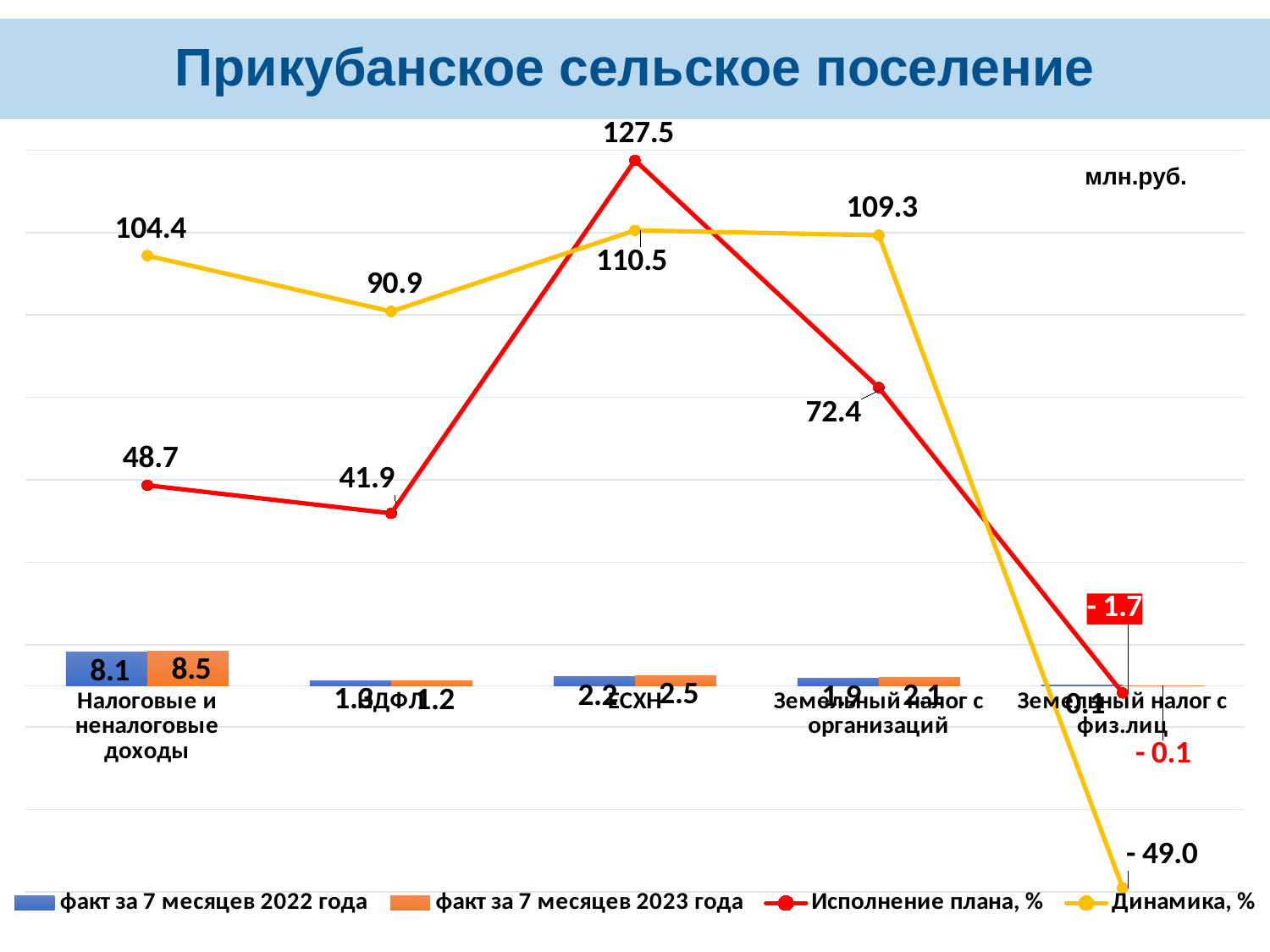
What is the title of the slide? Прикубанское сельское поселение What is the difference between факт за 7 месяцев 2023 года and факт за 7 месяцев 2022 года for Налоговые и неналоговые доходы? 0.4 What is the value of Динамика, % for Земельный налог с физ.лиц? - 49.0 Which has the higher Исполнение плана, %: Налоговые и неналоговые доходы or НДФЛ? Налоговые и неналоговые доходы How many categories are shown on the x axis? 5 What is the difference between Исполнение плана, % for ЕСХН and for Земельный налог с организаций? 55.1 What is the value of факт за 7 месяцев 2023 года for Налоговые и неналоговые доходы? 8.5 Which category has the highest value of Исполнение плана, %? ЕСХН Which category has the lowest value of Динамика, %? Земельный налог с физ.лиц What is the value of Исполнение плана, % for ЕСХН? 127.5 What is the value of Динамика, % for Налоговые и неналоговые доходы? 104.4 How many series does the legend list? 4